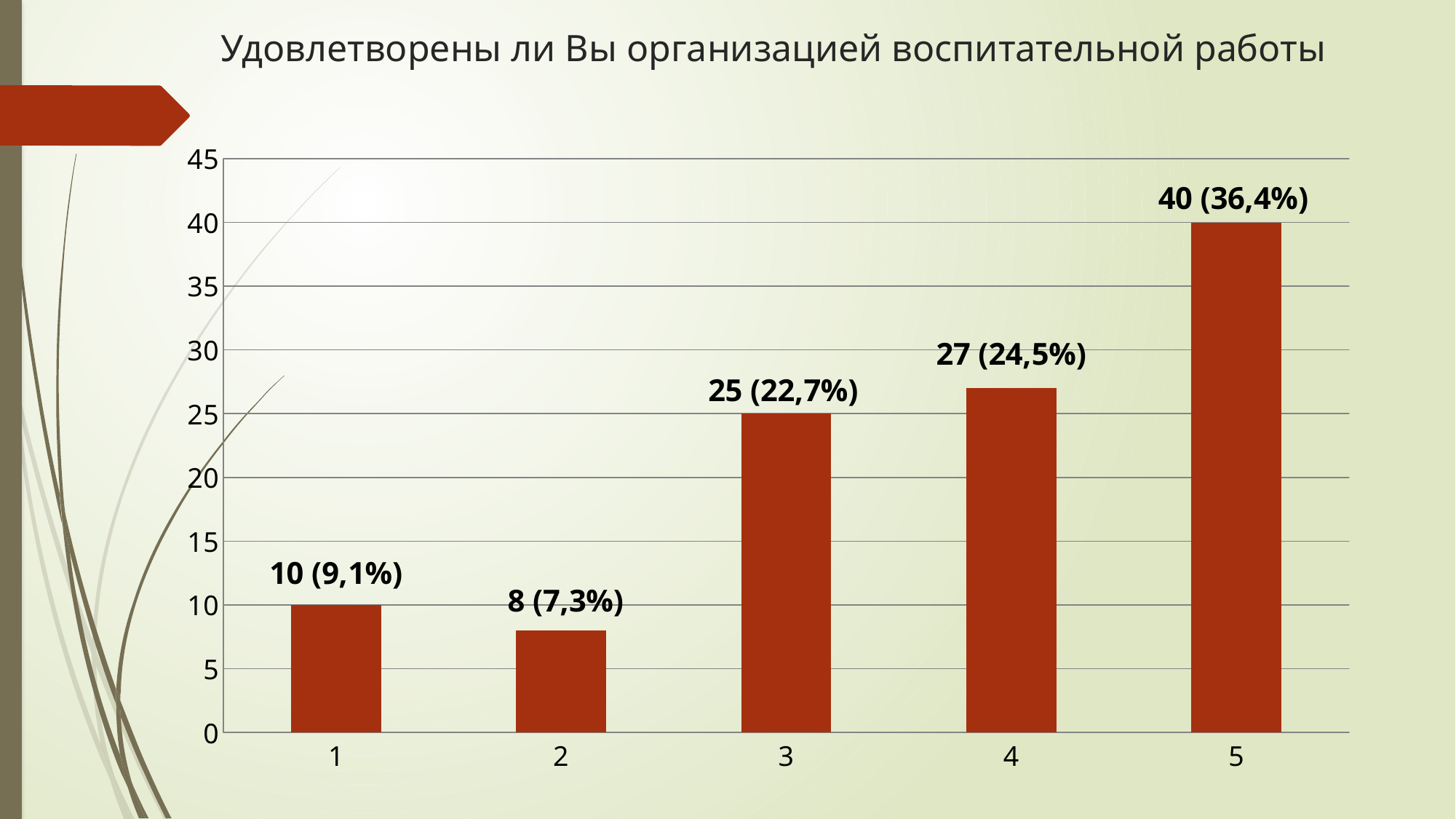
What is the data label shown for category 1? 10 (9,1%) What is the data label shown for category 5? 40 (36,4%) What is the title of the chart? Удовлетворены ли Вы организацией воспитательной работы Is the value for category 4 greater or less than 30? less Which is larger, the value for category 3 or the value for category 4? 4 What is the data label shown for category 3? 25 (22,7%) How many categories are shown on the x axis? 5 Which category has the highest value? 5 Which category has the lowest value? 2 What kind of chart is shown on the slide? bar chart What is the difference between the count for category 5 and the count for category 4? 13 What is the difference between the count for category 1 and the count for category 2? 2